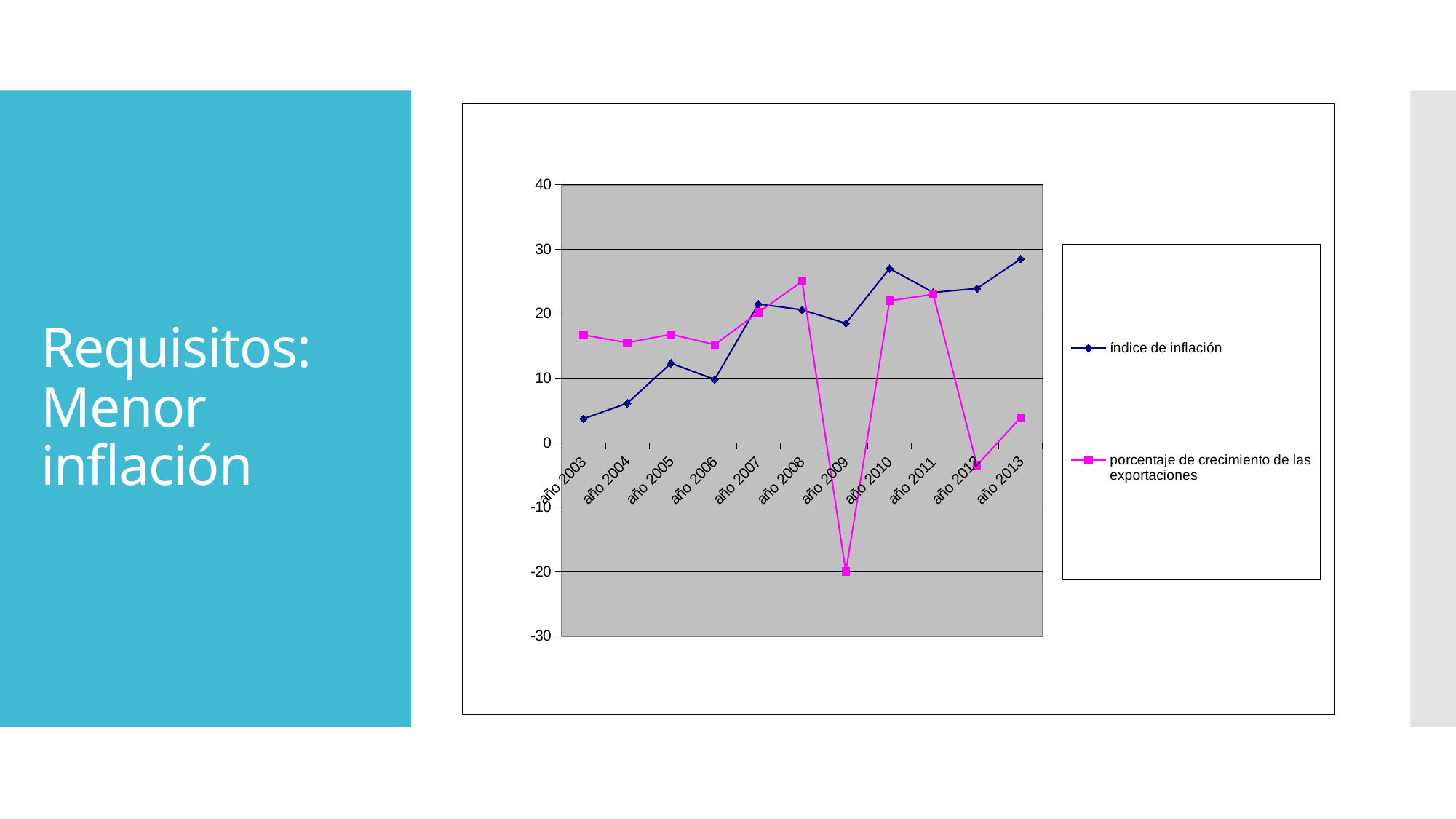
Is the value of 'porcentaje de crecimiento de las exportaciones' for año 2013 greater or less than 10? less Is the value of 'índice de inflación' for año 2003 greater or less than 10? less In which year is the 'porcentaje de crecimiento de las exportaciones' series at its lowest? año 2009 What kind of chart is shown on the slide? line chart How many series does the legend list? 2 Is the value of 'porcentaje de crecimiento de las exportaciones' for año 2009 greater or less than -10? less For año 2009, which series has the larger value: 'índice de inflación' or 'porcentaje de crecimiento de las exportaciones'? índice de inflación Does the 'índice de inflación' series generally rise or fall from año 2003 to año 2013? rise In which year is the 'índice de inflación' series at its highest? año 2013 In which year is the 'índice de inflación' series at its lowest? año 2003 How many years are plotted along the x axis? 11